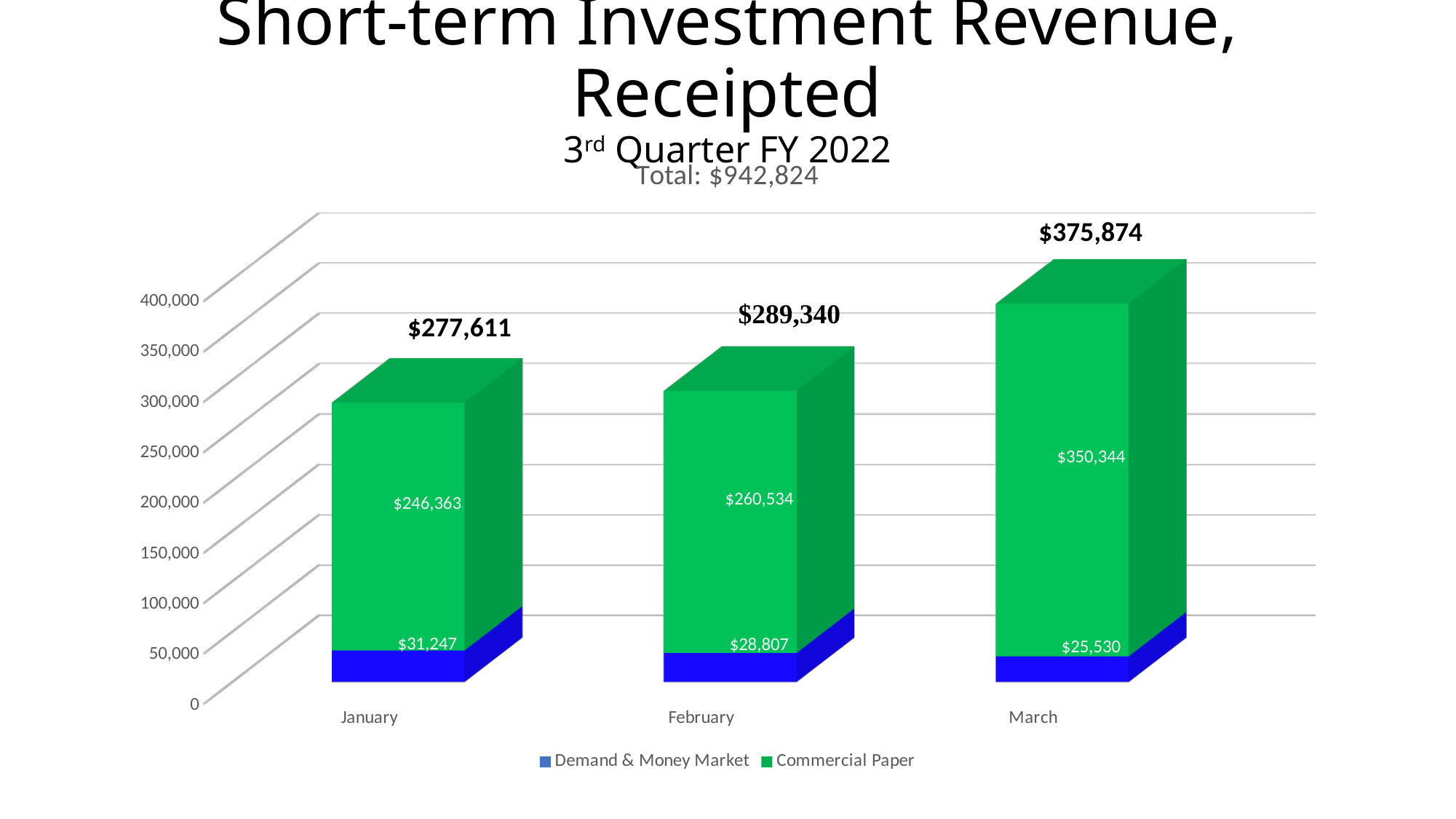
Which month has the highest total stacked bar? March How many series does the legend list? 2 How many months are shown on the x axis? 3 What is the Demand & Money Market value for January? $31,247 What is the Commercial Paper value for February? $260,534 Which is larger, the Demand & Money Market value for January or for February? January What is the total of the stacked bar for February? $289,340 What is the Demand & Money Market value for March? $25,530 What is the Commercial Paper value for March? $350,344 Which month has the lowest Demand & Money Market value? March What is the difference between the Commercial Paper values for March and January? $103,981 Do the total values rise or fall from January to March? rise